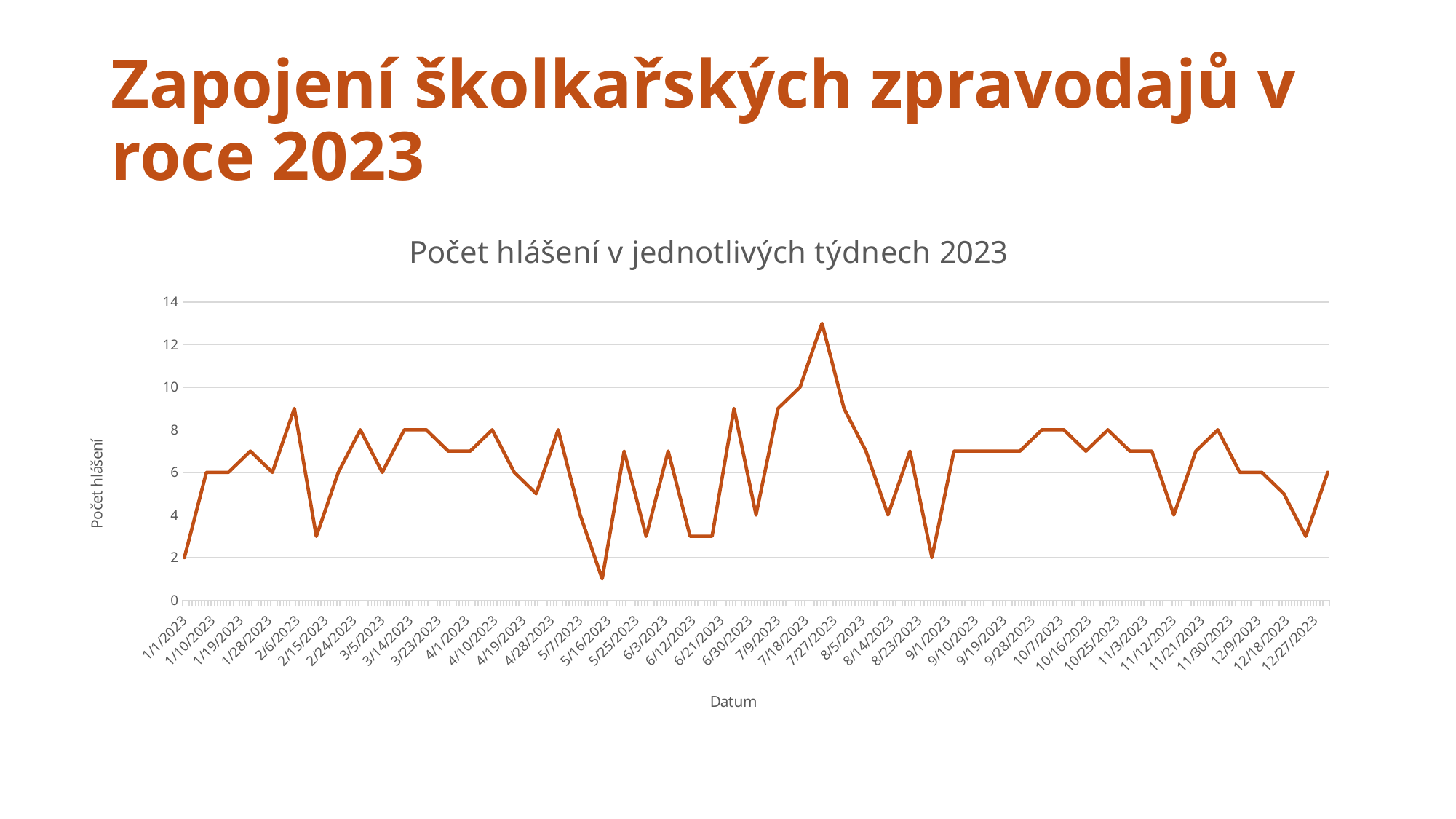
Which is larger, the value at 7/27/2023 or the value at 5/16/2023? 7/27/2023 What is the label of the vertical axis? Počet hlášení Is the value at 5/16/2023 greater or less than 2? less What is the value at 12/27/2023? 6 Around which date does the line reach its highest value? 7/27/2023 Is the value at 1/1/2023 greater or less than 4? less What is the title of the chart? Počet hlášení v jednotlivých týdnech 2023 Around which date does the line reach its lowest value? 5/16/2023 What kind of chart is shown on the slide? line chart What is the value at 1/1/2023? 2 Does the line rise or fall between 7/9/2023 and 7/27/2023? rise Is the value at 7/27/2023 greater or less than 12? greater